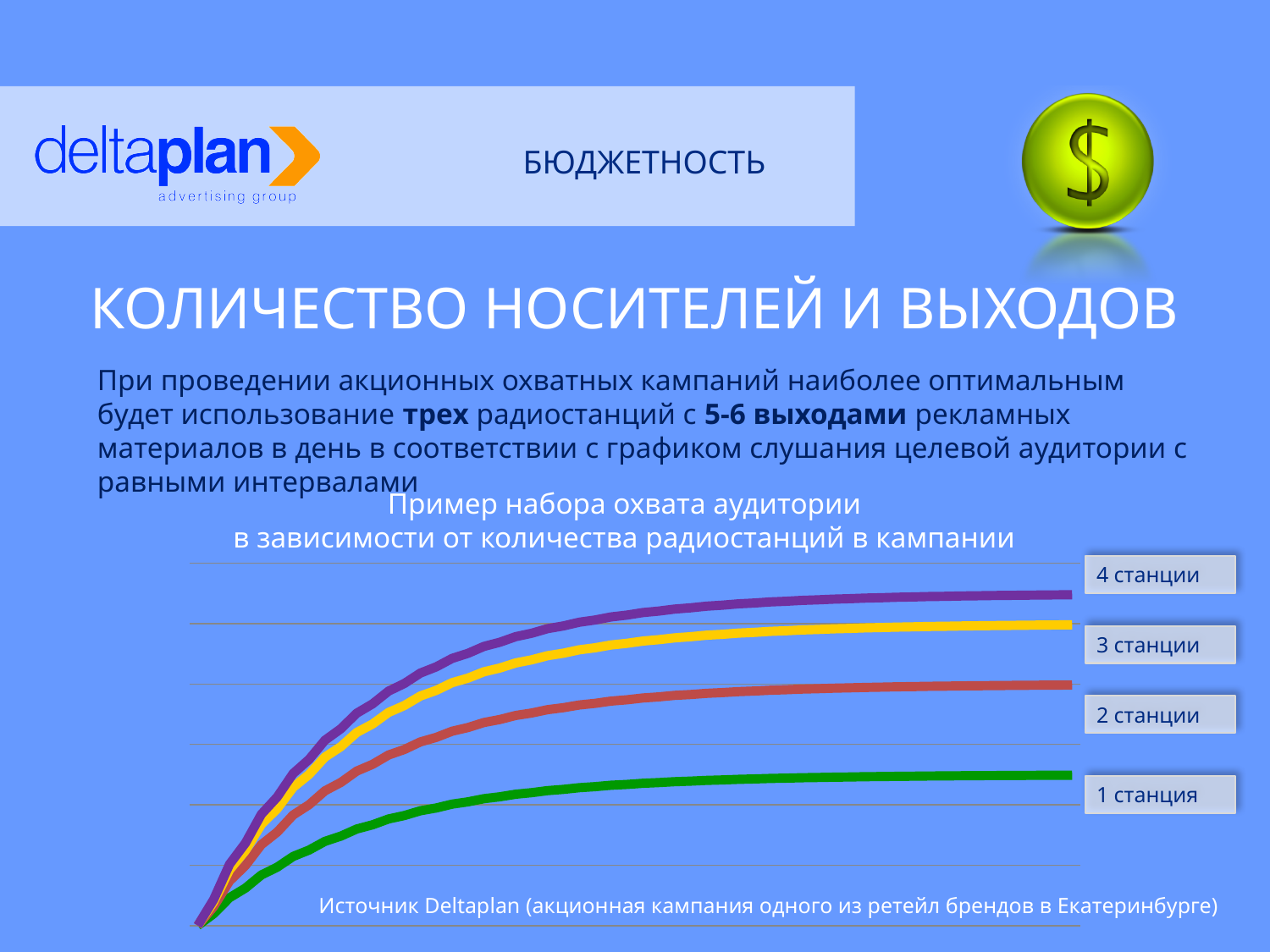
What colour is the line labelled 1 станция? green Which series is drawn in yellow? 3 станции Which series ends higher on the right side of the chart: 1 станция or 2 станции? 2 станции What kind of chart is shown on the slide? line chart Which series stays lowest on the chart? 1 станция What colour is the line labelled 4 станции? purple Do the lines rise or fall as they move from left to right along the x axis? rise How many series (lines) does the chart show? 4 Which series ends higher on the right side of the chart: 3 станции or 2 станции? 3 станции Which series reaches the highest level on the chart? 4 станции